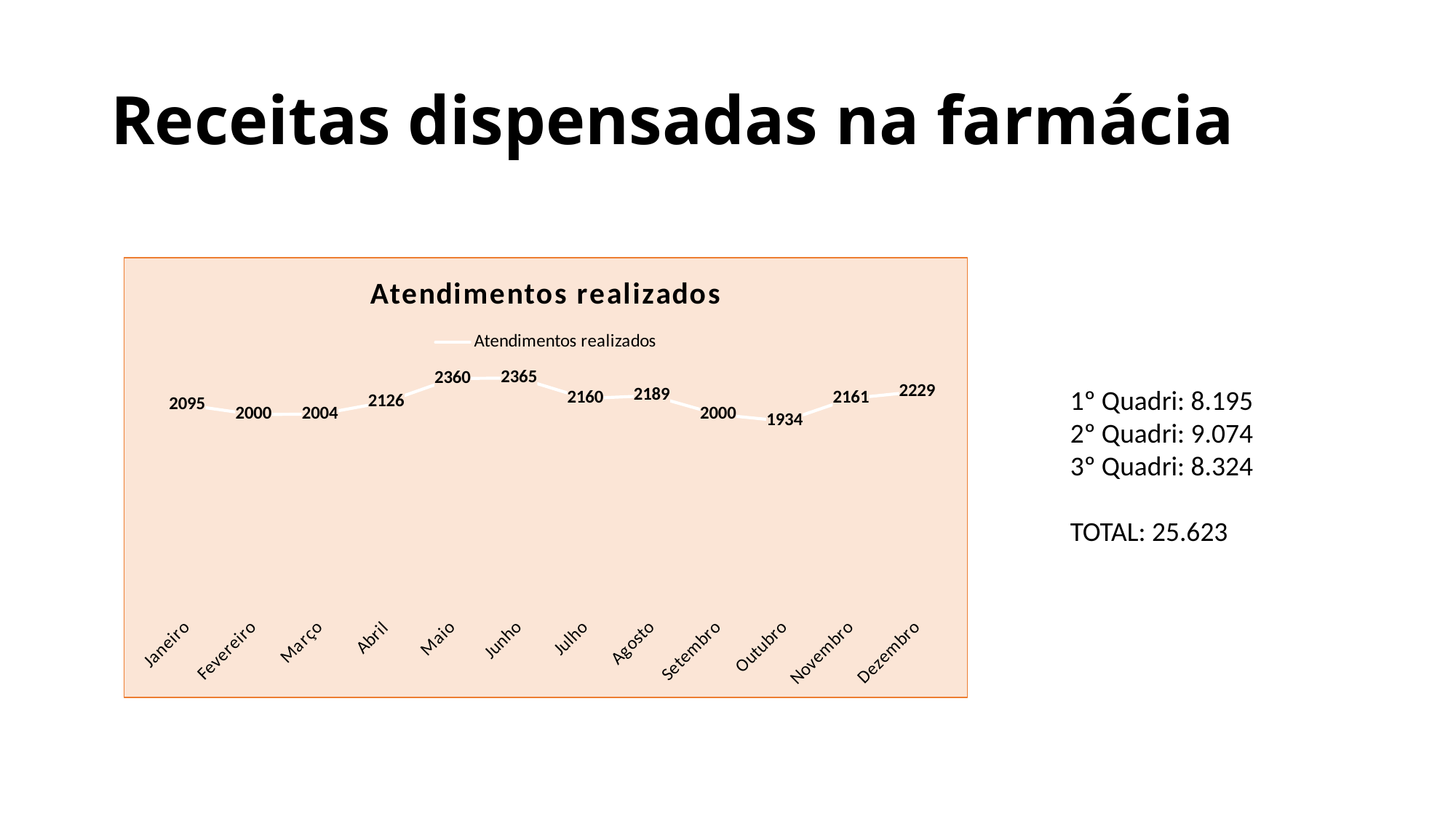
Do the values rise or fall from Março to Junho? rise What type of chart is shown on the slide? line chart How many series does the chart legend list? 1 What is the value for Maio? 2360 How many months are plotted on the x axis of the chart? 12 What is the value for Outubro? 1934 What is the value for Dezembro? 2229 Which month has the lowest value? Outubro Which is larger, the value for Agosto or the value for Julho? Agosto What is the title of the chart? Atendimentos realizados Which month has the highest value? Junho What is the difference between the values for Maio and Abril? 234